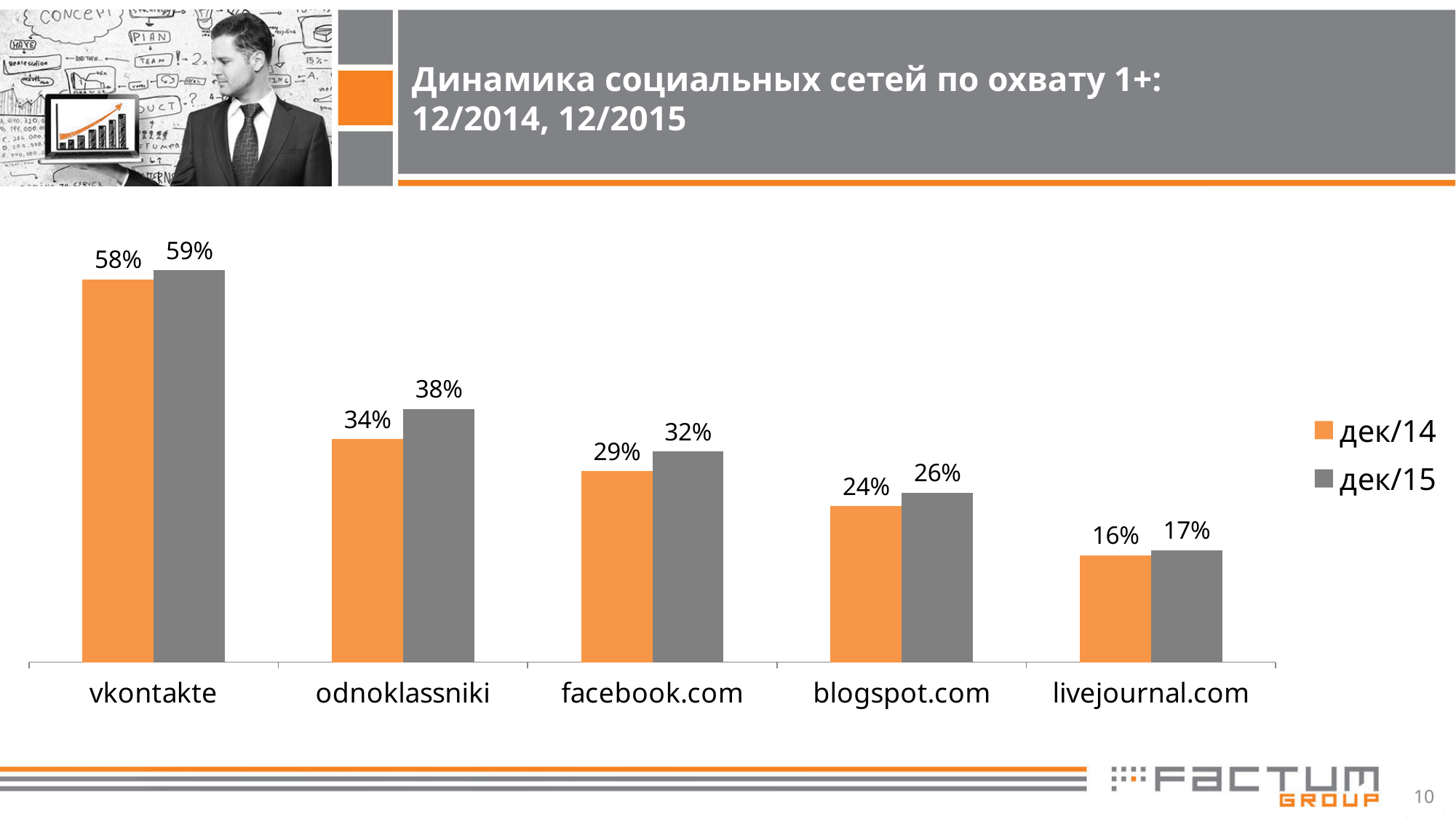
What is the value for vkontakte in the дек/15 series? 59% What is the value for facebook.com in the дек/15 series? 32% How many categories are shown on the x axis? 5 What kind of chart is shown on the slide? bar chart Which category has the highest value in the дек/15 series? vkontakte Which category has the lowest value in the дек/14 series? livejournal.com Which is larger for blogspot.com: the дек/14 value or the дек/15 value? дек/15 Which colour represents the дек/14 series in the legend? orange What is the difference between the дек/15 and дек/14 values for odnoklassniki? 4% What is the value for odnoklassniki in the дек/14 series? 34% What is the value for livejournal.com in the дек/14 series? 16% How many series does the legend list? 2